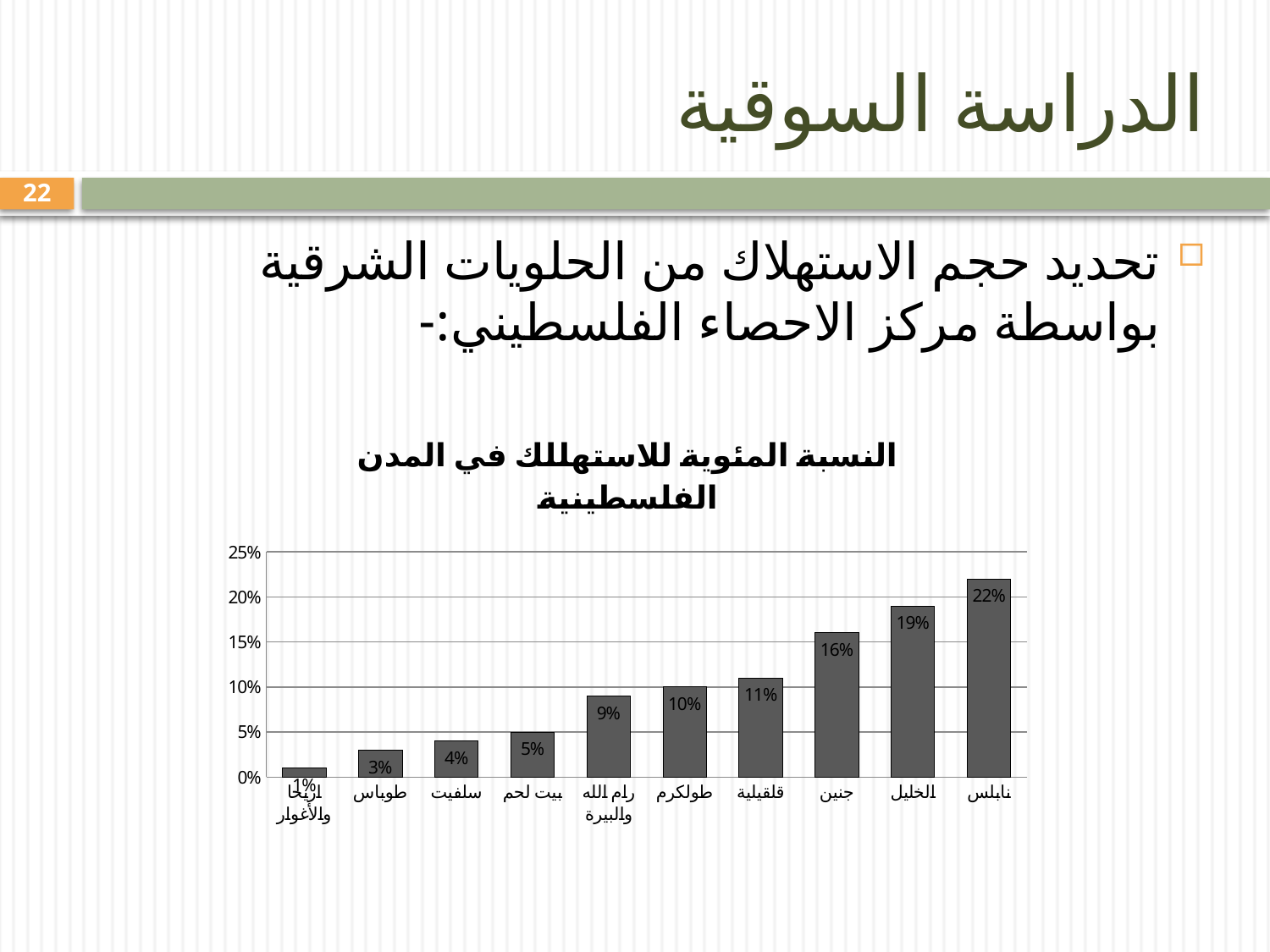
Do the values rise or fall from left to right along the x axis? rise How many cities are shown on the chart? 10 What kind of chart is shown on the slide? bar chart Which city has the highest consumption percentage? نابلس Which city has the lowest consumption percentage? أريحا والأغوار What is the value for نابلس? 22% What is the value for رام الله والبيرة? 9% What is the difference between the values for نابلس and الخليل? 3% Which is larger, the value for طولكرم or the value for بيت لحم? طولكرم Is the value for الخليل greater or less than 15%? greater What is the value for جنين? 16% What is the difference between the values for جنين and قلقيلية? 5%